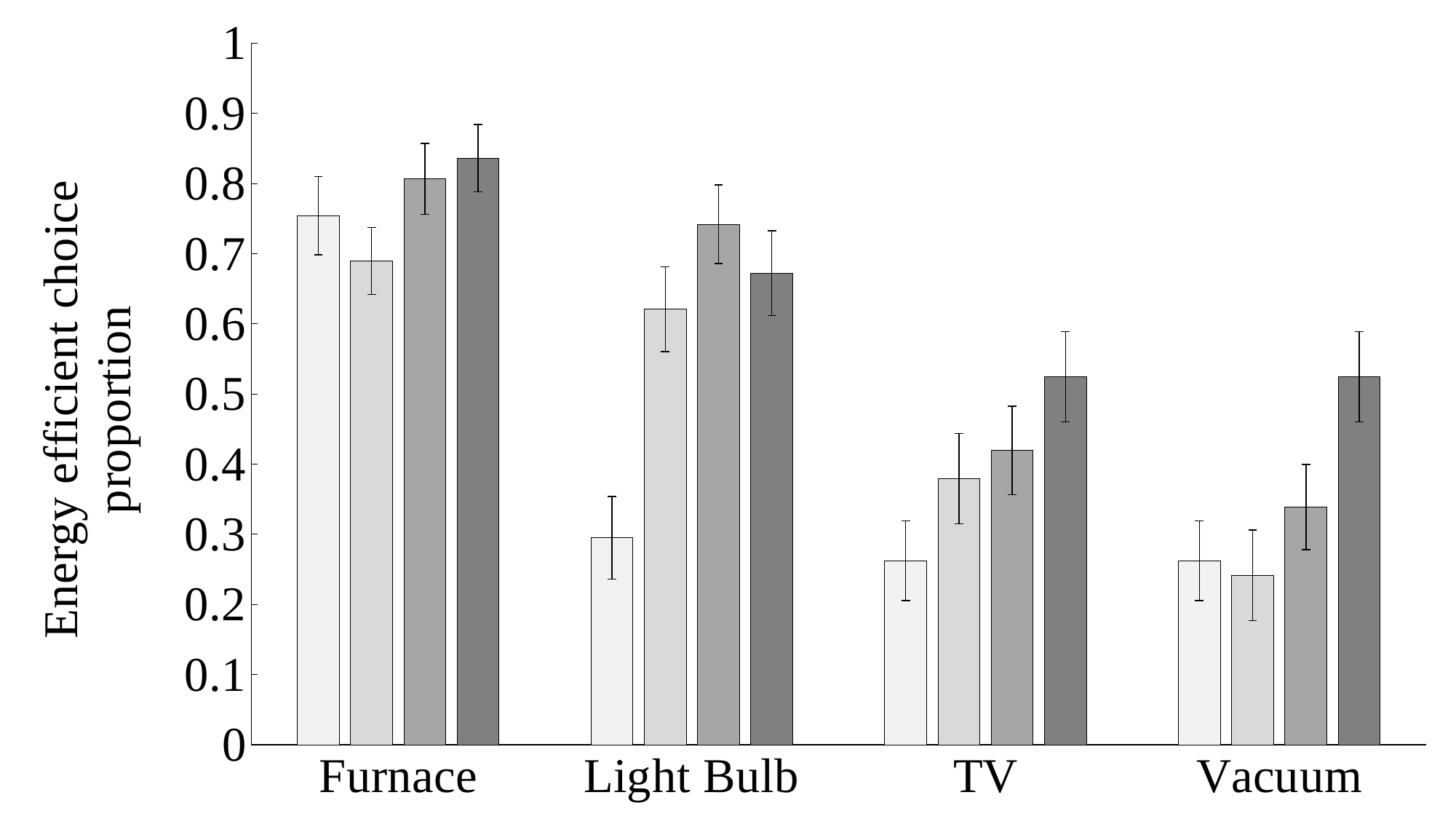
Which category has the tallest darkest bar? Furnace Within the Light Bulb group, which bar is the lowest? the lightest bar How many bars are plotted for each category? 4 What kind of chart is shown on the slide? bar chart Is the value of the darkest bar for TV greater or less than 0.6? less What is the title of the y axis? Energy efficient choice proportion How many categories are shown on the x axis? 4 Is the value of the darkest bar for Furnace greater or less than 0.8? greater Is the value of the second-lightest bar for Furnace greater or less than 0.6? greater Within the TV group, do the bars rise or fall from left to right? rise Which is larger: the lightest bar for Furnace or the lightest bar for Vacuum? Furnace